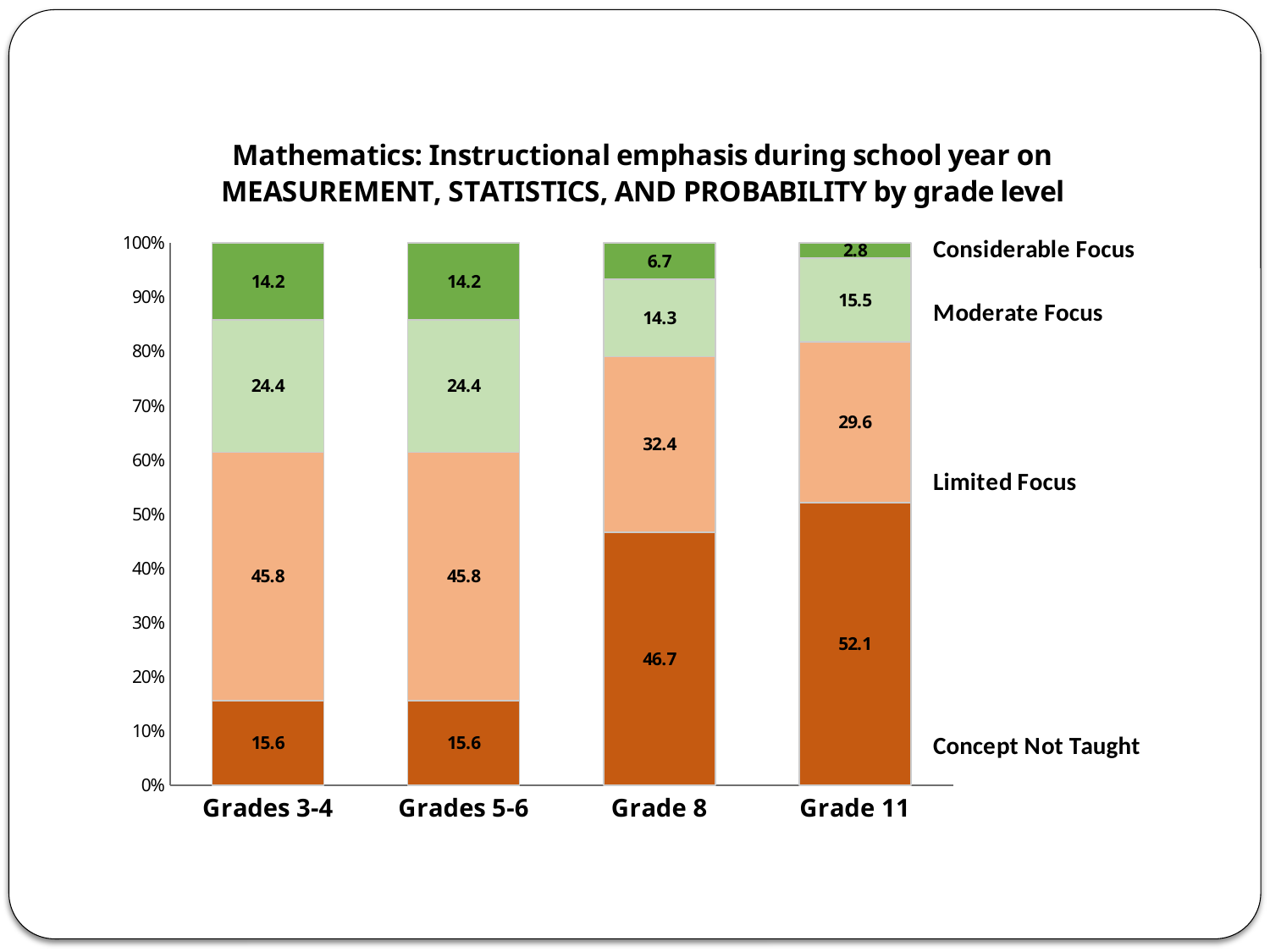
What is the Moderate Focus value for Grade 11? 15.5 Does the Considerable Focus value rise or fall from Grades 5-6 to Grade 11? Fall What is the Concept Not Taught value for Grade 11? 52.1 What is the difference between the Concept Not Taught values for Grade 8 and Grades 5-6? 31.1 How many grade-level categories are shown on the x axis? 4 What kind of chart is shown on the slide? Stacked bar chart Which is larger, the Limited Focus value for Grade 8 or for Grade 11? Grade 8 How many series (focus levels) does the chart show? 4 What is the Limited Focus value for Grades 3-4? 45.8 Which grade level has the highest Concept Not Taught value? Grade 11 What is the Considerable Focus value for Grade 8? 6.7 Which grade level has the lowest Considerable Focus value? Grade 11